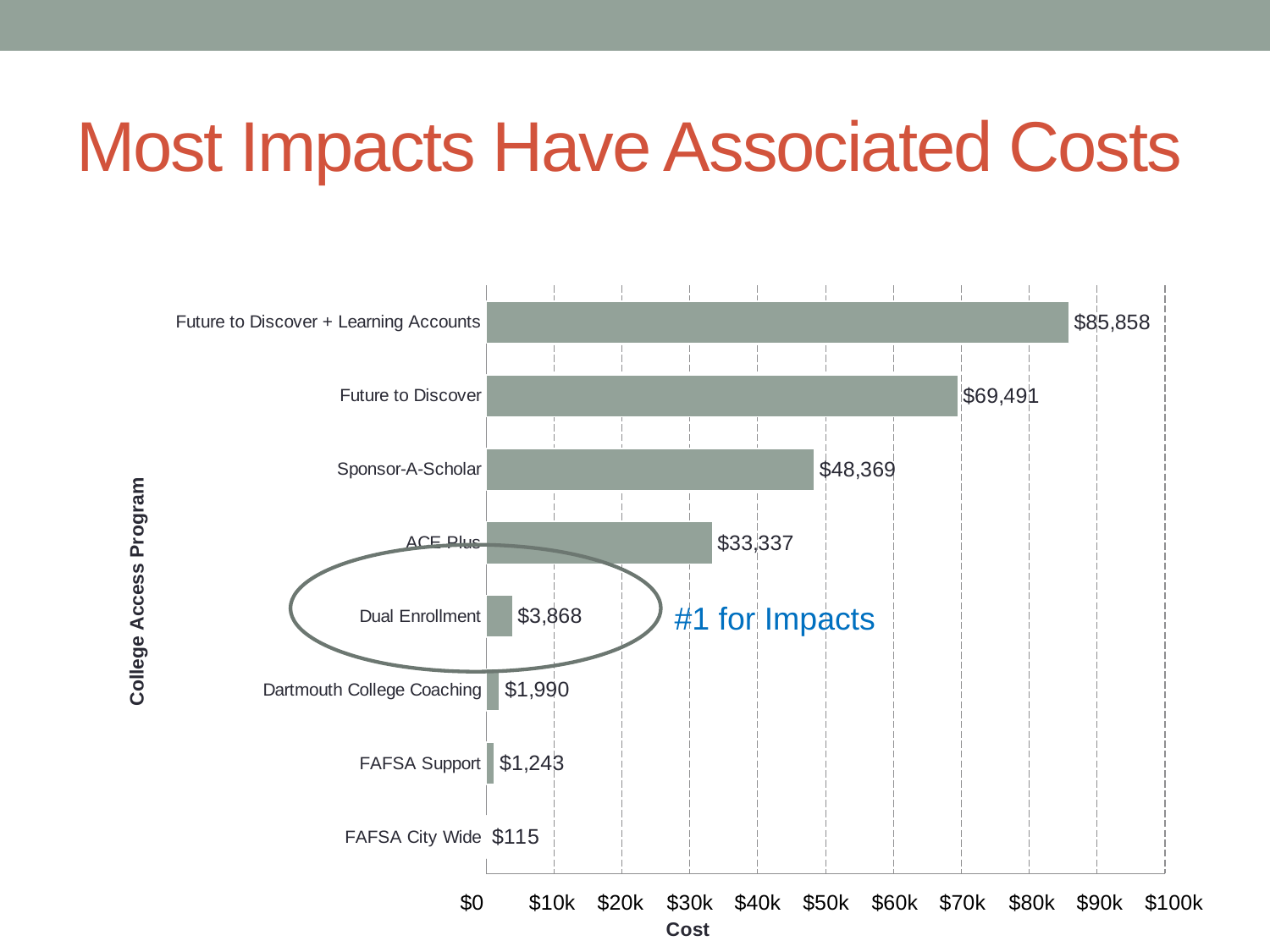
Which college access program has the highest cost? Future to Discover + Learning Accounts What is the cost for Dual Enrollment? $3,868 Which college access program has the lowest cost? FAFSA City Wide Is the cost for Future to Discover greater or less than $60k? greater How many college access programs are shown in the chart? 8 What is the difference in cost between Future to Discover + Learning Accounts and Future to Discover? $16,367 What is the difference in cost between Dual Enrollment and Dartmouth College Coaching? $1,878 Which has a higher cost, Sponsor-A-Scholar or ACE Plus? Sponsor-A-Scholar What is the cost for FAFSA City Wide? $115 What kind of chart is shown on the slide? Bar chart Which program is circled and annotated as '#1 for Impacts'? Dual Enrollment What is the cost for Sponsor-A-Scholar? $48,369